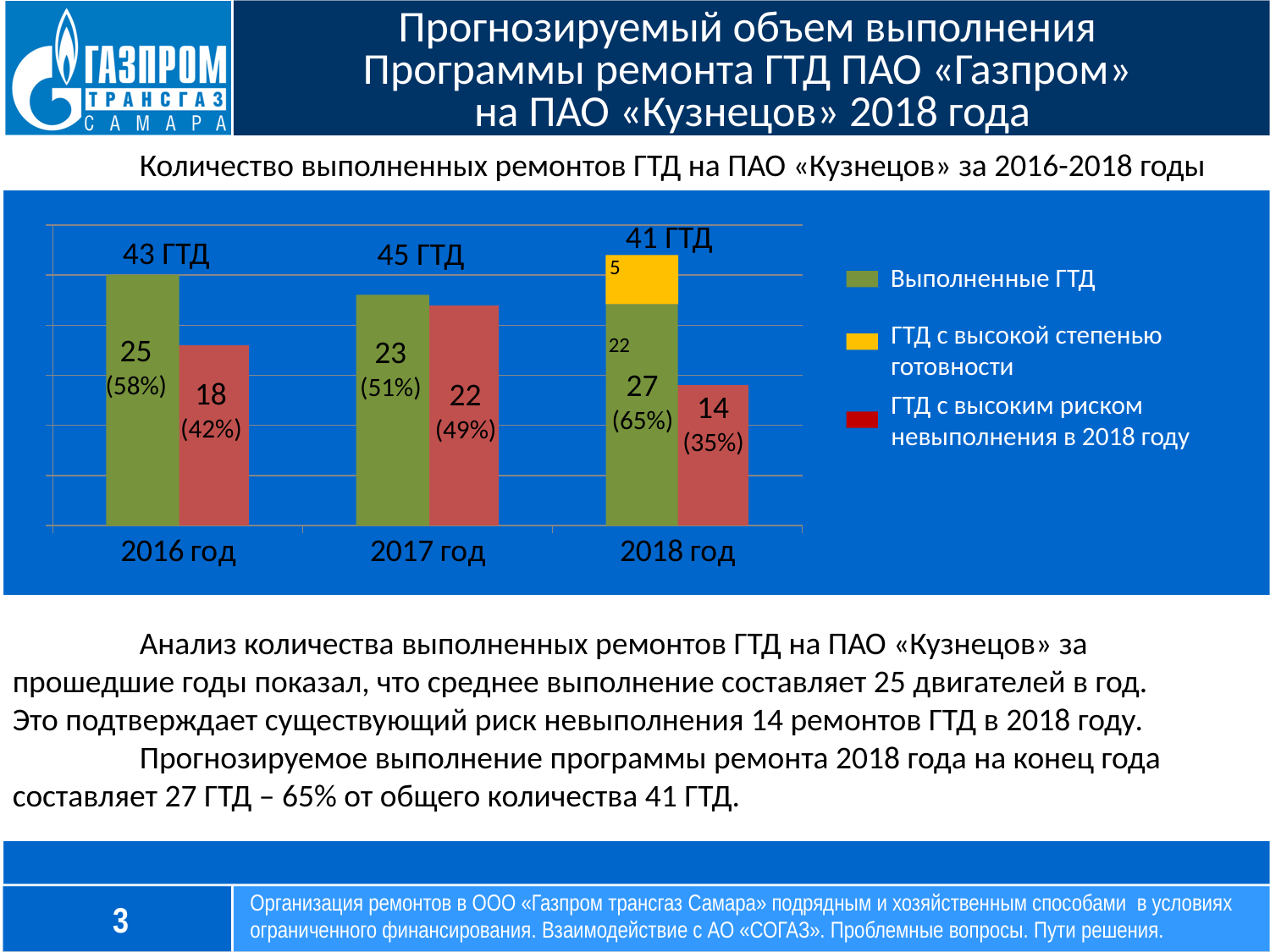
How many year categories are shown on the x axis of the chart? 3 Which year has the highest total number of ГТД labelled above its bars? 2017 год What is the value of the green bar (Выполненные ГТД) for 2017 год? 23 What type of chart is shown on the slide? bar chart How many series does the chart legend list? 3 What is the difference between the green bar value and the red bar value for 2016 год? 7 Which year has the lowest value for the red bar (ГТД с высоким риском невыполнения)? 2018 год What is the value of the red bar (ГТД с высоким риском невыполнения) for 2016 год? 18 Which is larger in 2017 год: the green bar (23) or the red bar (22)? the green bar (23) What percentage is shown for the red bar in 2018 год? 35% What total number of ГТД is labelled above the bars for 2018 год? 41 ГТД What is the value of the yellow segment (ГТД с высокой степенью готовности) in 2018 год? 5